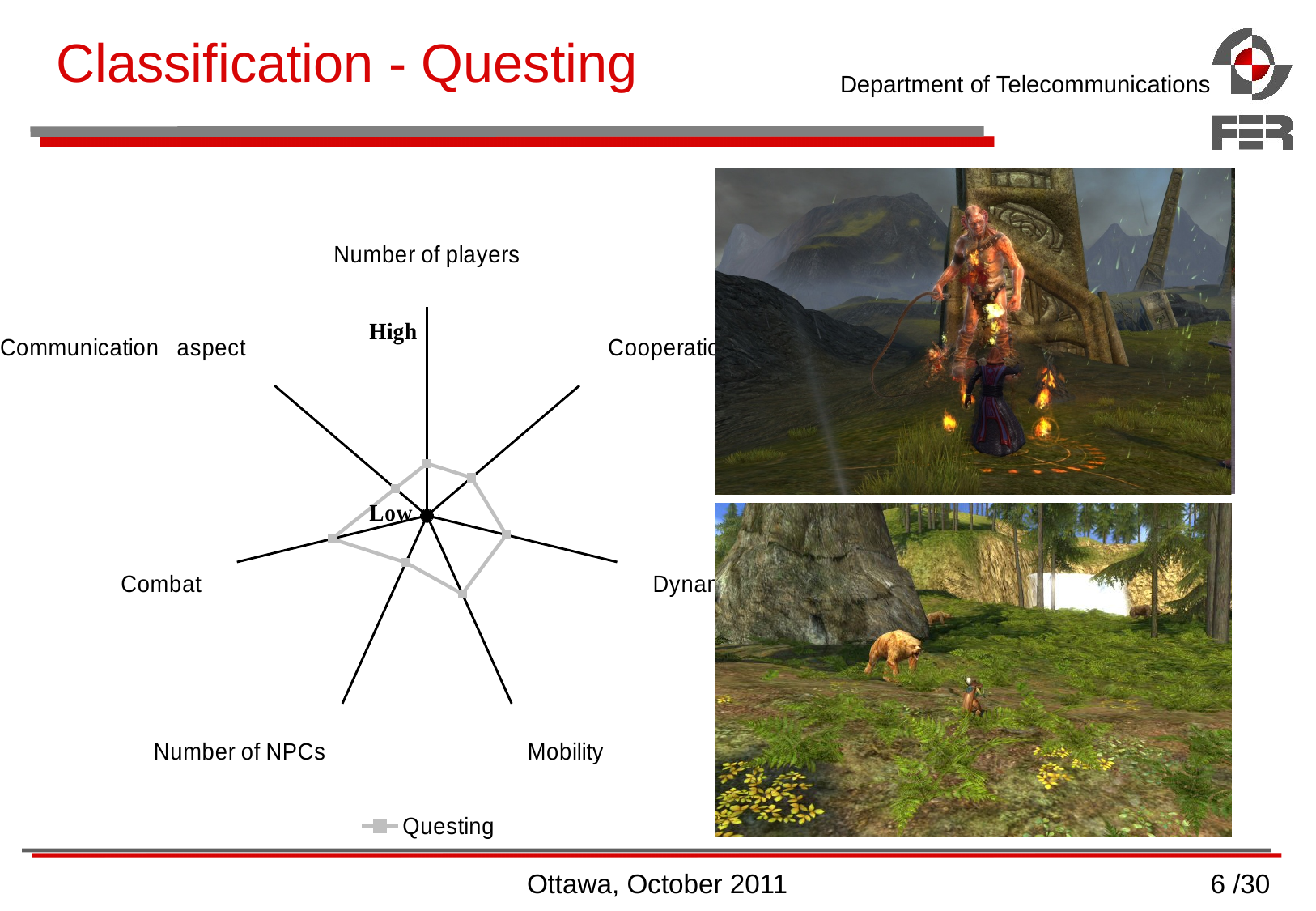
What kind of chart is shown on the slide? Radar chart Which has the higher value for Questing, Mobility or Number of NPCs? Mobility How many axes (categories) does the radar chart have? 7 What are the two scale labels shown on the radar chart's axis? High and Low What is the name of the series shown in the chart legend? Questing Which has the higher value for Questing, Combat or Number of players? Combat Which has the higher value for Questing, Combat or Communication aspect? Combat How many series does the chart legend list? 1